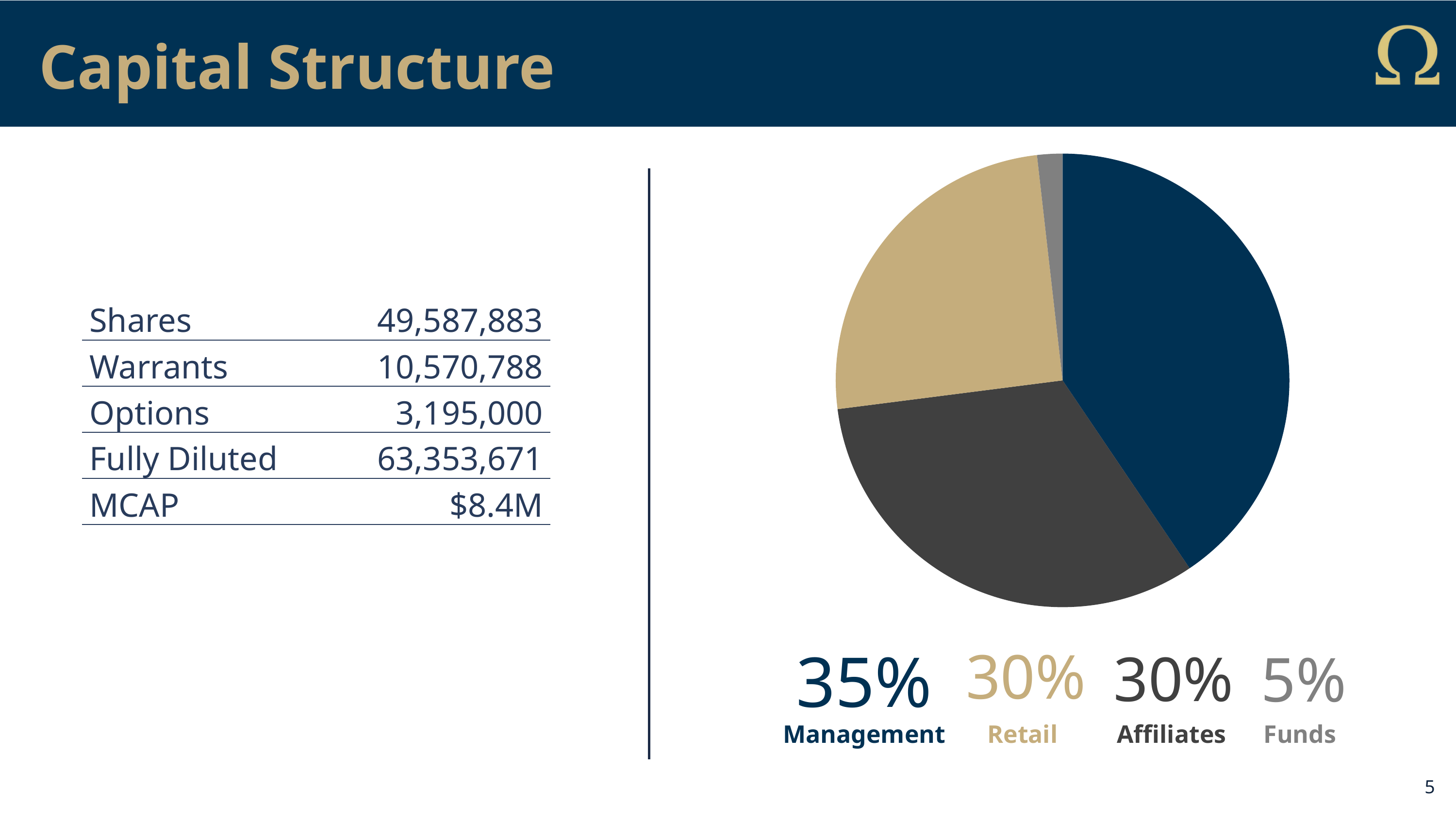
What share of the pie chart does Funds hold? 5% What is the difference in percentage points between the Management and Affiliates slices? 5 What share of the pie chart does Affiliates hold? 30% Which category has the smallest slice of the pie chart? Funds What share of the pie chart does Retail hold? 30% What colour is the Retail slice of the pie chart? gold How many slices does the pie chart have? 4 Which slice is larger, Management or Retail? Management Which category has the largest slice of the pie chart? Management What kind of chart is shown on the slide? pie chart What share of the pie chart does Management hold? 35% What is the difference in percentage points between the Management and Funds slices? 30